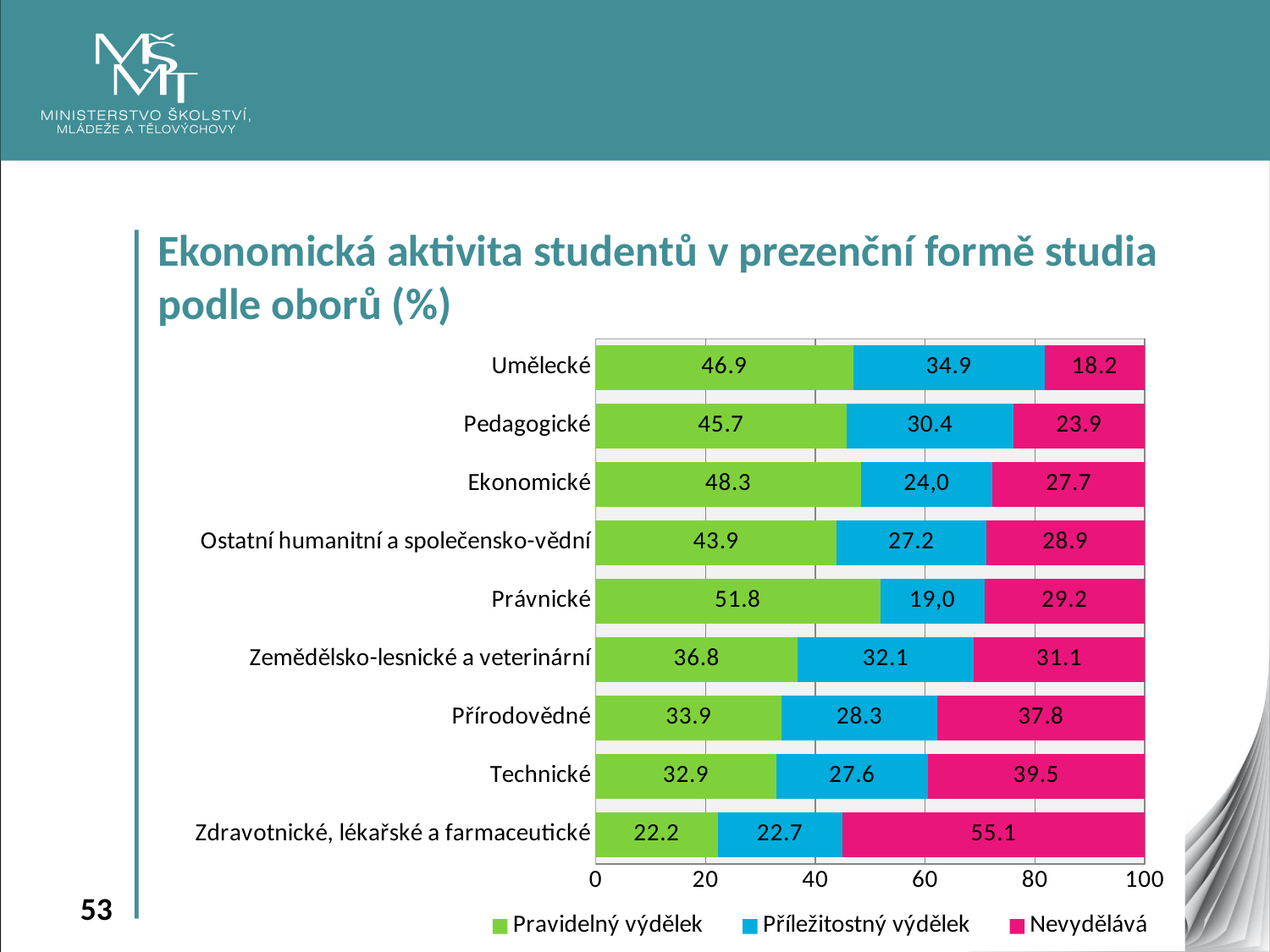
Which colour represents Nevydělává in the chart? Pink Which category has the highest value for Pravidelný výdělek? Právnické Which category has the lowest value for Nevydělává? Umělecké What is the value of Nevydělává for Zdravotnické, lékařské a farmaceutické? 55.1 Which category has the highest value for Příležitostný výdělek? Umělecké For Přírodovědné, which is larger: Pravidelný výdělek or Nevydělává? Nevydělává How many categories (fields of study) are shown in the chart? 9 What is the difference between Pravidelný výdělek and Nevydělává for Umělecké? 28.7 What type of chart is shown on the slide? Stacked bar chart How many series does the legend list? 3 What is the value of Příležitostný výdělek for Ekonomické? 24,0 What is the value of Pravidelný výdělek for Právnické? 51.8